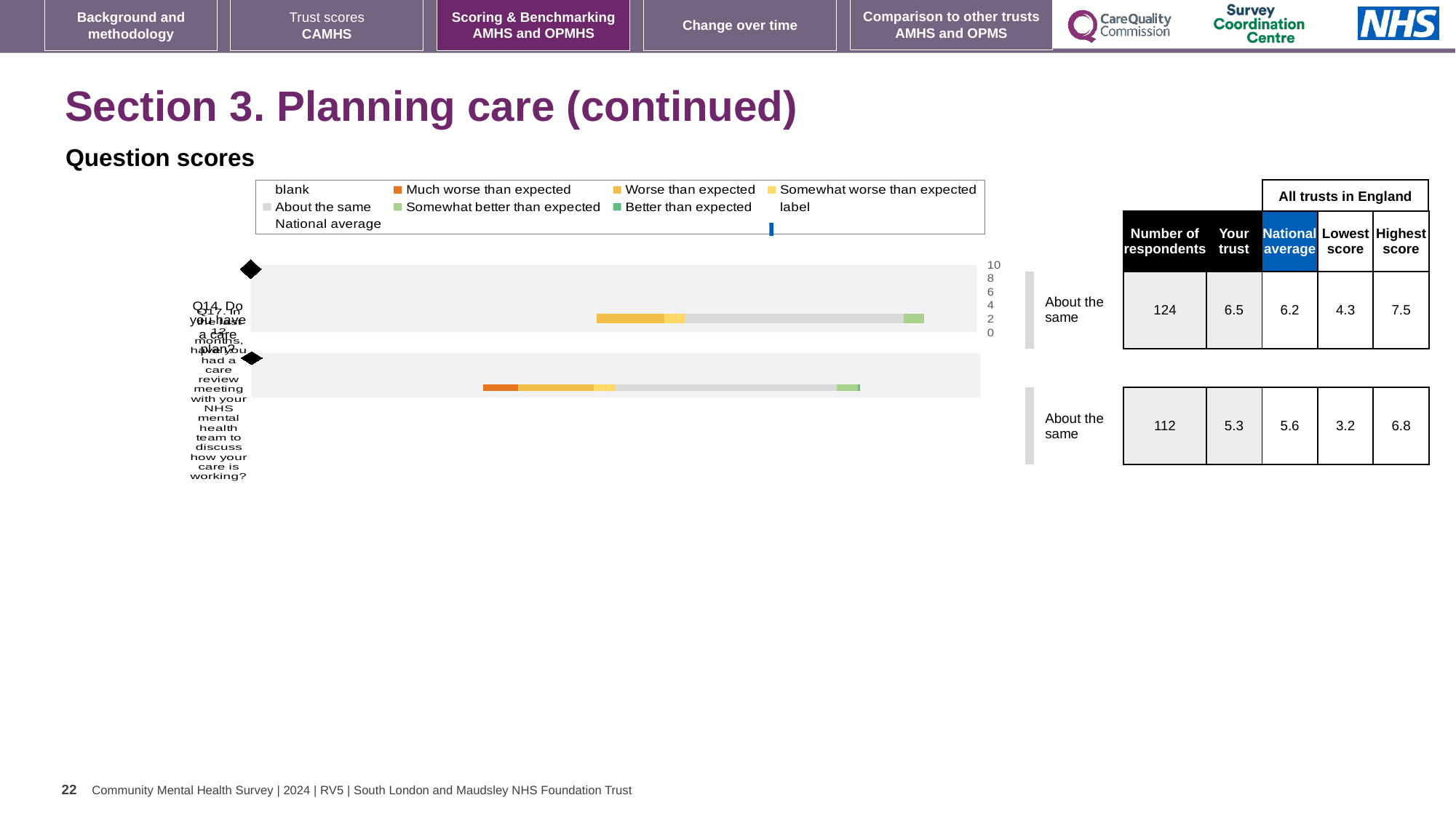
What is the highest score across all trusts in England for Q17? 6.8 What kind of chart is used to show the question scores on this slide? bar chart In the table beside the chart, what is the 'Your trust' score for Q14 (Do you have a care plan?)? 6.5 What benchmark category is shown for both Q14 and Q17 next to the chart? About the same What is the lowest score across all trusts in England for Q14? 4.3 In the table beside the chart, what is the national average for Q17 (care review meeting)? 5.6 What is the difference between the 'Your trust' score and the national average for Q14? 0.3 How many questions (bars) are plotted in the question scores chart? 2 For Q17, which is higher: the 'Your trust' score or the national average? National average Which of the two questions has more respondents? Q14 How many respondents answered Q14 according to the table beside the chart? 124 For Q14, which is higher: the 'Your trust' score or the national average? Your trust